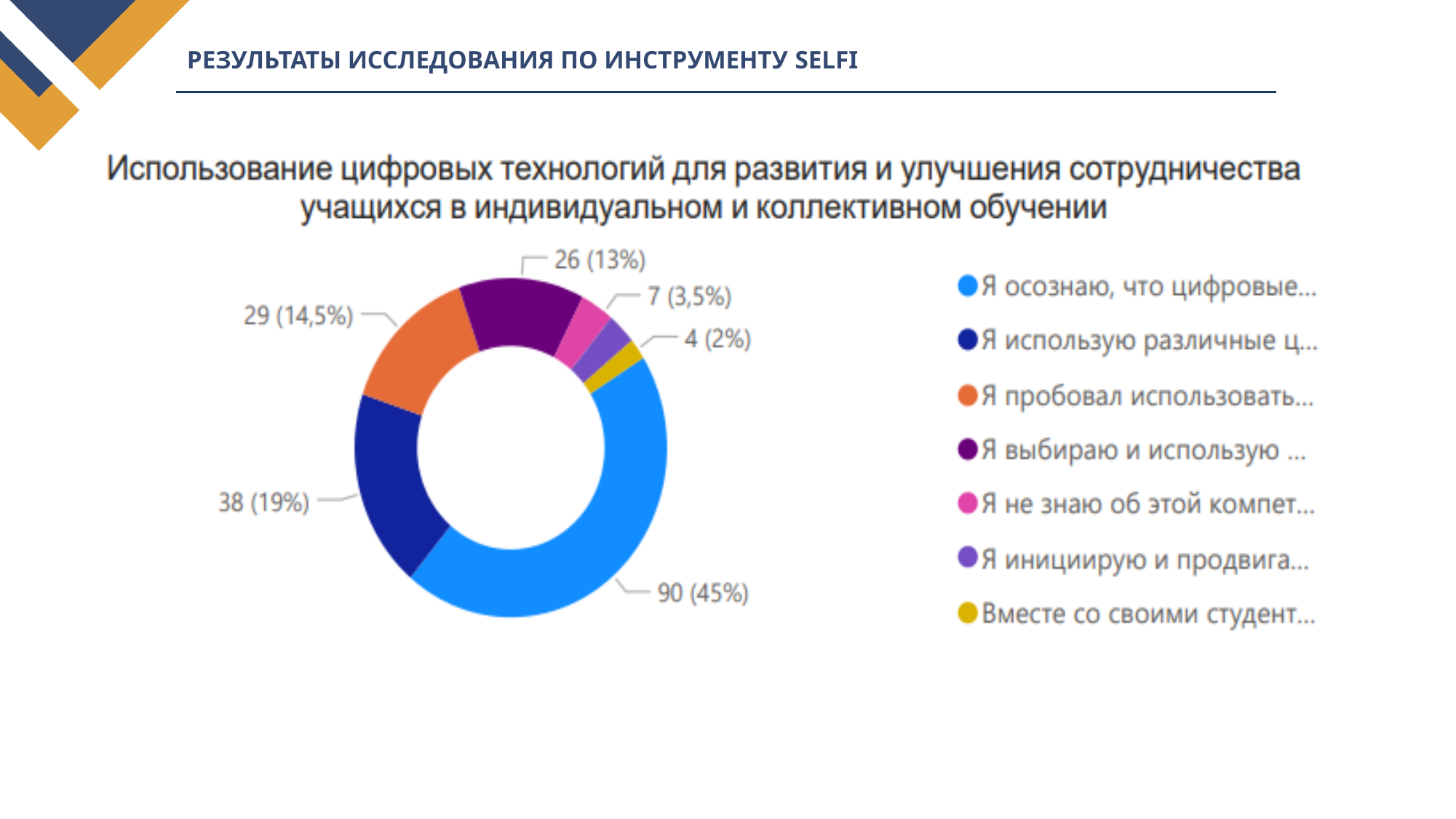
Which legend category has the largest slice of the chart? Я осознаю, что цифровые... How many entries does the legend of the chart list? 7 What colour is the slice for "Я пробовал использовать..."? Orange What value and share are shown for the slice "Я использую различные ц..."? 38 (19%) What value and share are shown for the slice "Я выбираю и использую ..."? 26 (13%) What value and share are shown for the slice "Я осознаю, что цифровые..."? 90 (45%) What is the difference between the values for "Я осознаю, что цифровые..." and "Я использую различные ц..."? 52 What value and share are shown for the slice "Вместе со своими студент..."? 4 (2%) Which is larger: the slice for "Я пробовал использовать..." or the slice for "Я выбираю и использую ..."? Я пробовал использовать... What share of the chart does the slice "Я не знаю об этой компет..." represent? 3,5% What kind of chart is shown on the slide? Donut (pie) chart What value and share are shown for the slice "Я пробовал использовать..."? 29 (14,5%)